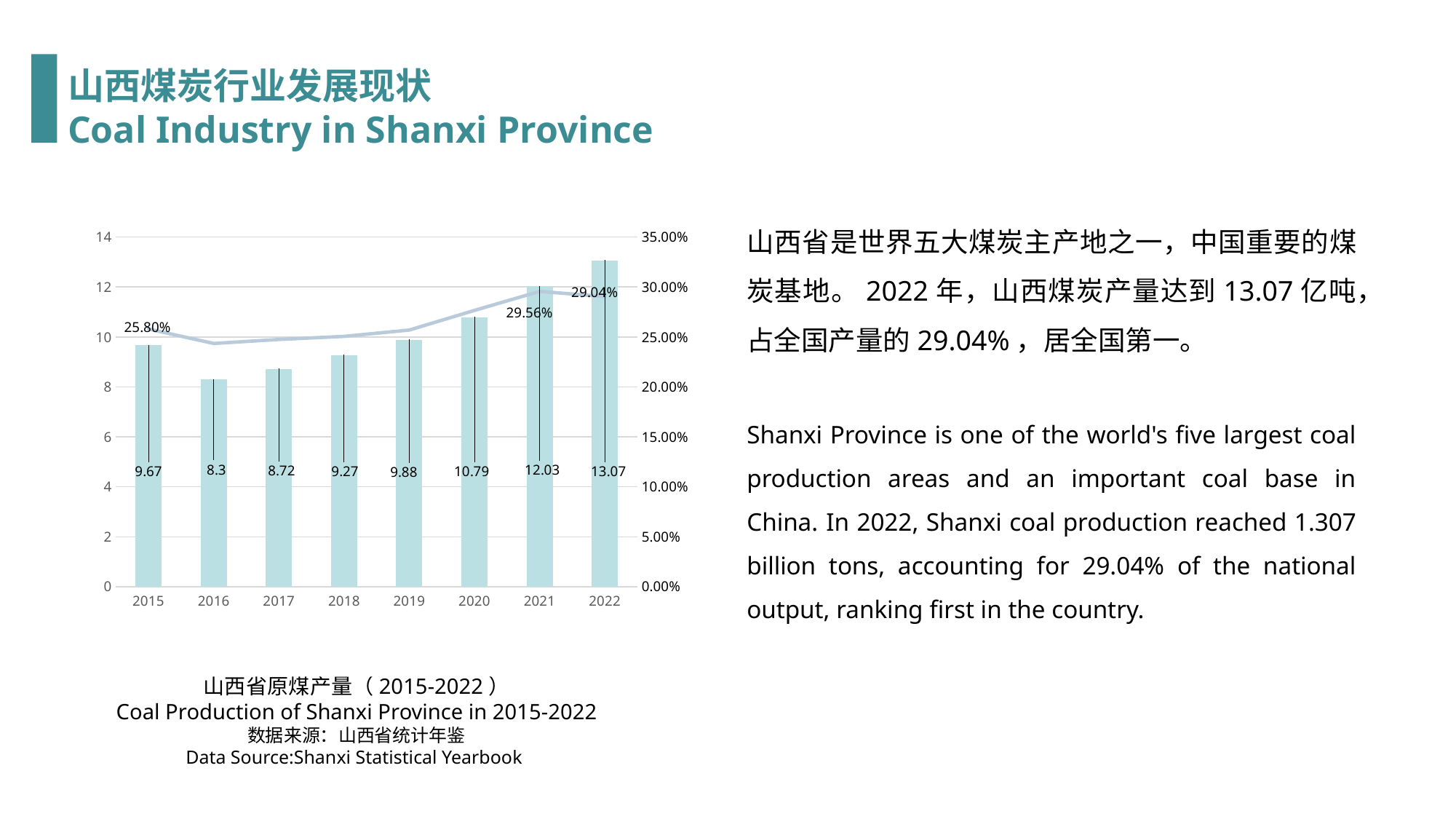
What is the difference between the coal production values for 2022 and 2021? 1.04 Which year has the highest coal production bar? 2022 What percentage is labelled on the line for 2015? 25.80% What is the coal production value shown for 2019? 9.88 What is the English title of the chart? Coal Production of Shanxi Province in 2015-2022 Which year has a larger coal production value, 2017 or 2018? 2018 What is the coal production value shown for 2016? 8.3 How many years are shown on the x axis of the chart? 8 Is the line value for 2019 greater or less than 30.00%? less Do the coal production bars generally rise or fall from 2016 to 2022? rise Which year has the lowest coal production bar? 2016 What percentage is labelled on the line for 2021? 29.56%